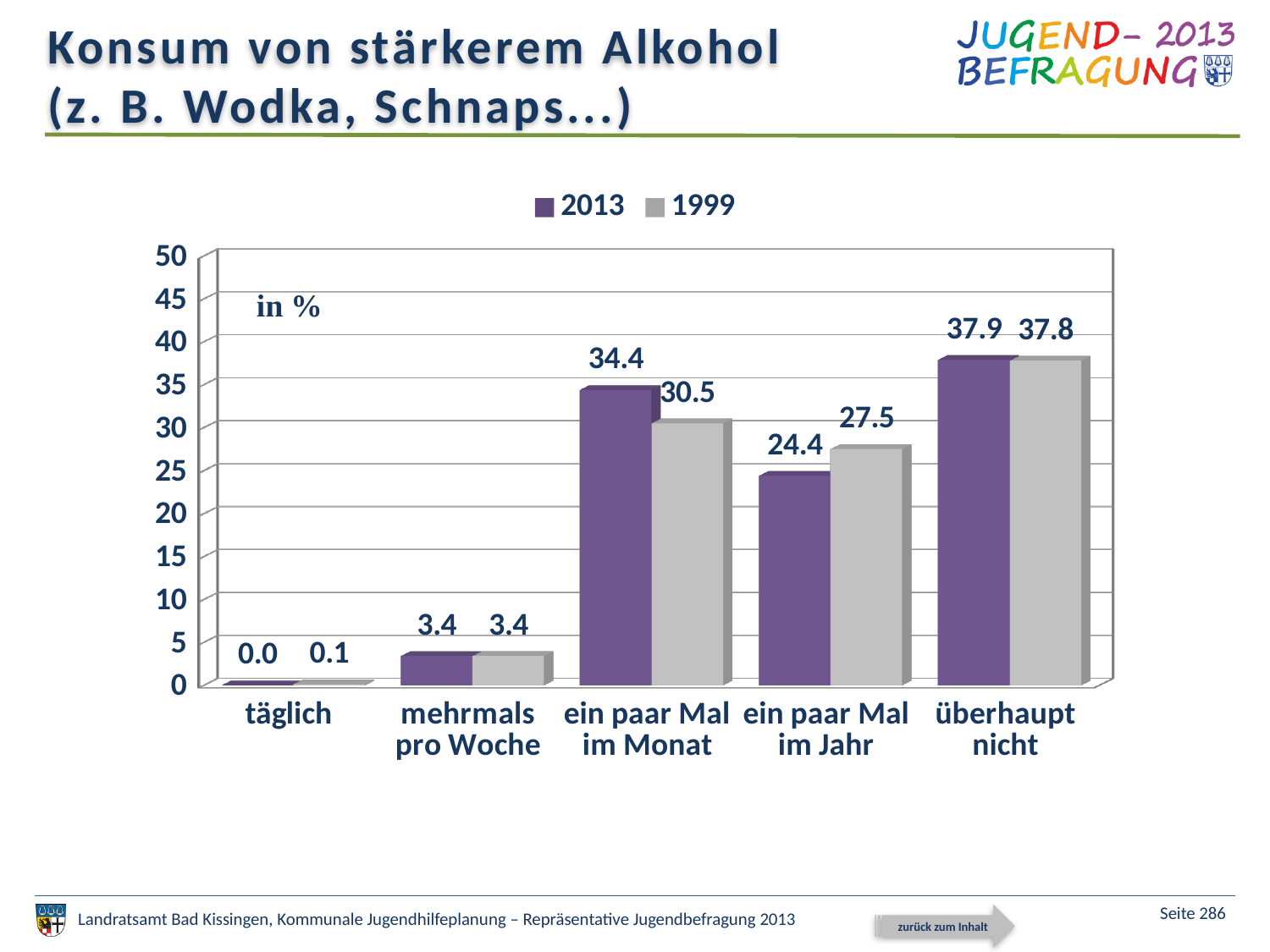
Which category has the highest 2013 value? überhaupt nicht Is the 2013 value for "ein paar Mal im Jahr" greater or less than 25? less Which category has the lowest 1999 value? täglich How many series does the legend list? 2 What is the 1999 value for "täglich"? 0.1 What kind of chart is shown on the slide? bar chart For "ein paar Mal im Jahr", which series has the larger value, 2013 or 1999? 1999 What is the 1999 value for "ein paar Mal im Jahr"? 27.5 How many categories are shown on the x axis? 5 What is the difference between the 2013 and 1999 values for "ein paar Mal im Monat"? 3.9 Which series is shown in purple? 2013 What is the 2013 value for "ein paar Mal im Monat"? 34.4